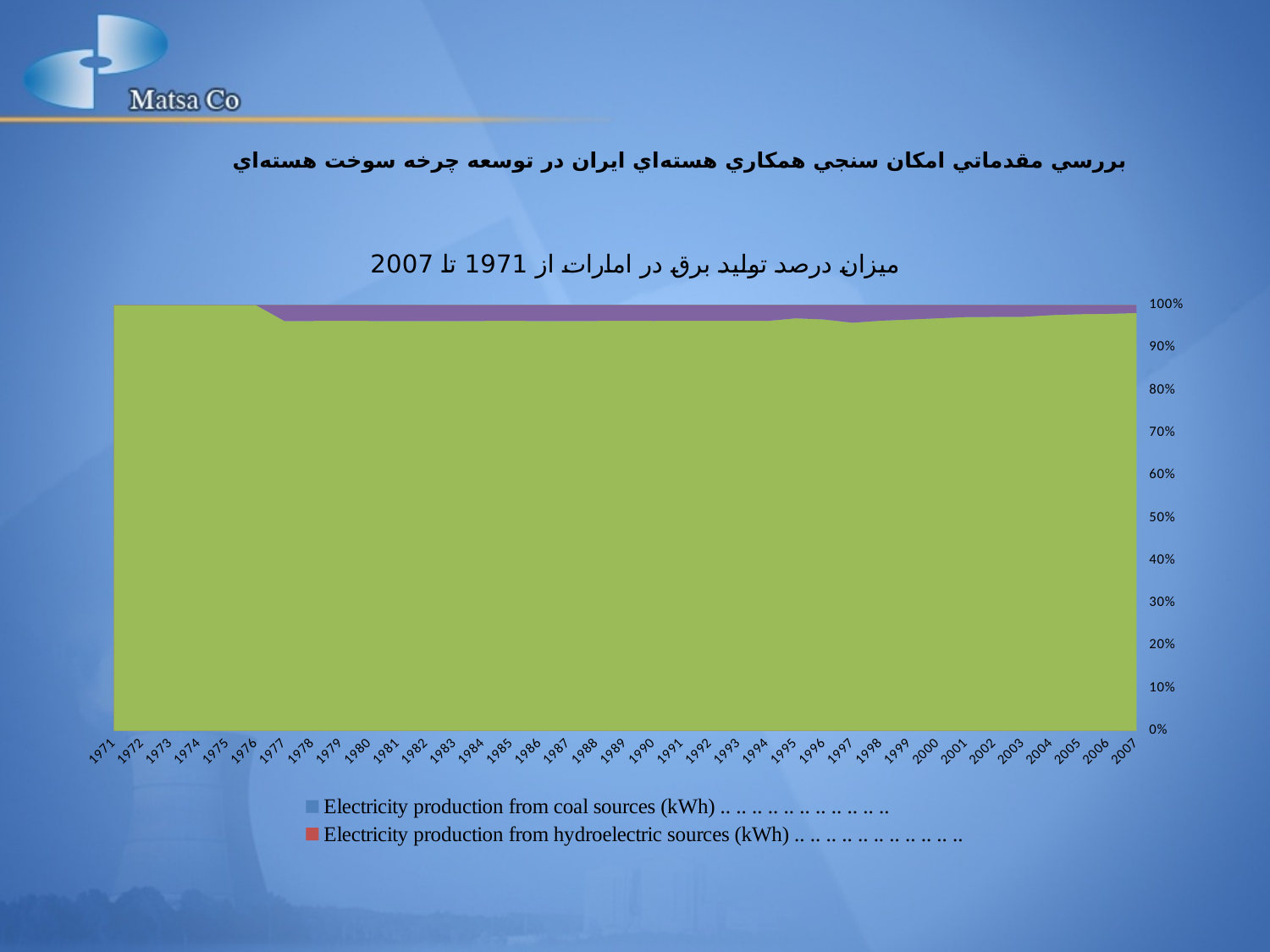
Is the share of the purple area in 2000 greater or less than 10%? less How many years are shown along the x axis of the chart? 37 What is the second entry listed in the chart's legend? Electricity production from hydroelectric sources (kWh) .. .. .. .. .. .. .. .. .. .. .. How many series does the chart's legend list? 2 What kind of chart is shown on the slide? Area chart What is the highest tick value shown on the y axis? 100% What is the first entry listed in the chart's legend? Electricity production from coal sources (kWh) .. .. .. .. .. .. .. .. .. .. .. In 2007, which area is larger, the green one or the purple one? The green one What is the last year shown on the x axis? 2007 What is the first year shown on the x axis? 1971 Is the share of the green area in 1990 greater or less than 90%? greater